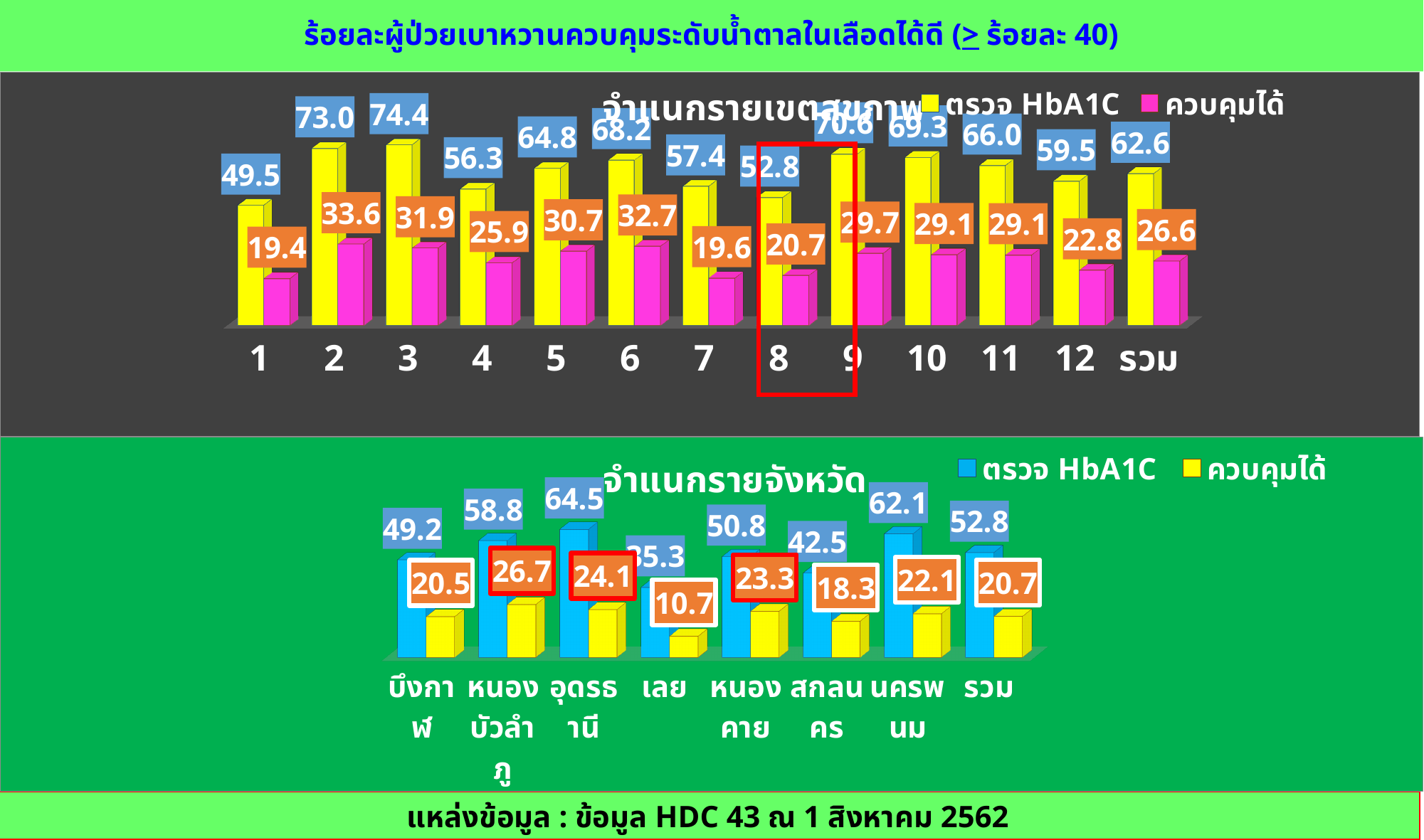
In the top chart (จำแนกรายเขตสุขภาพ), how many categories are shown on the x axis? 13 In the bottom chart (จำแนกรายจังหวัด), what is the ควบคุมได้ value for เลย? 10.7 In the bottom chart (จำแนกรายจังหวัด), how many series does the legend list? 2 In the bottom chart (จำแนกรายจังหวัด), what is the ตรวจ HbA1C value for นครพนม? 62.1 In the top chart (จำแนกรายเขตสุขภาพ), what is the ควบคุมได้ value for region 8? 20.7 In the bottom chart (จำแนกรายจังหวัด), which is larger, the ควบคุมได้ value for หนองบัวลำภู or for สกลนคร? หนองบัวลำภู In the top chart (จำแนกรายเขตสุขภาพ), what is the ตรวจ HbA1C value for region 3? 74.4 What kind of chart is the bottom chart (จำแนกรายจังหวัด)? Bar chart In the top chart (จำแนกรายเขตสุขภาพ), which region has the highest ควบคุมได้ value? 2 In the bottom chart (จำแนกรายจังหวัด), which province has the highest ตรวจ HbA1C value? อุดรธานี In the top chart (จำแนกรายเขตสุขภาพ), which region has the lowest ตรวจ HbA1C value? 1 In the top chart (จำแนกรายเขตสุขภาพ), what is the difference between the ตรวจ HbA1C and ควบคุมได้ values for รวม? 36.0